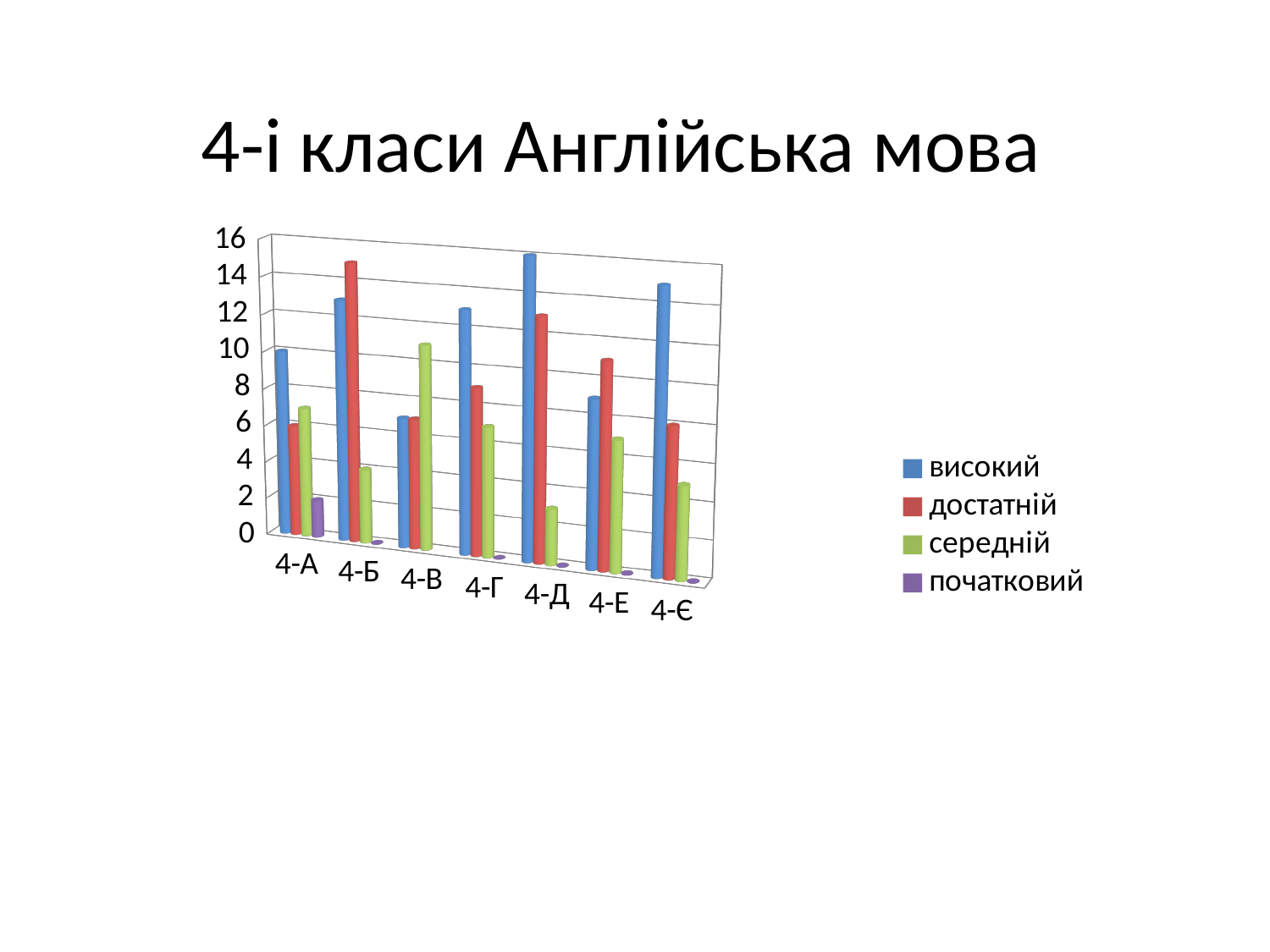
Which class has the highest value for 'достатній'? 4-Б What kind of chart is shown on the slide? bar chart Is the value for 'високий' in class 4-А greater or less than 8? greater Is the value for 'середній' in class 4-Д greater or less than 6? less How many series does the chart legend list? 4 Which class has the lowest value for 'середній'? 4-Д Which class has the lowest value for 'високий'? 4-В Which colour represents the series 'початковий' in the legend? purple For class 4-Б, which is larger: 'високий' or 'достатній'? достатній How many classes (categories) are shown on the x axis of the chart? 7 Which class has the highest value for 'середній'? 4-В What is the title of the slide with the chart? 4-і класи Англійська мова